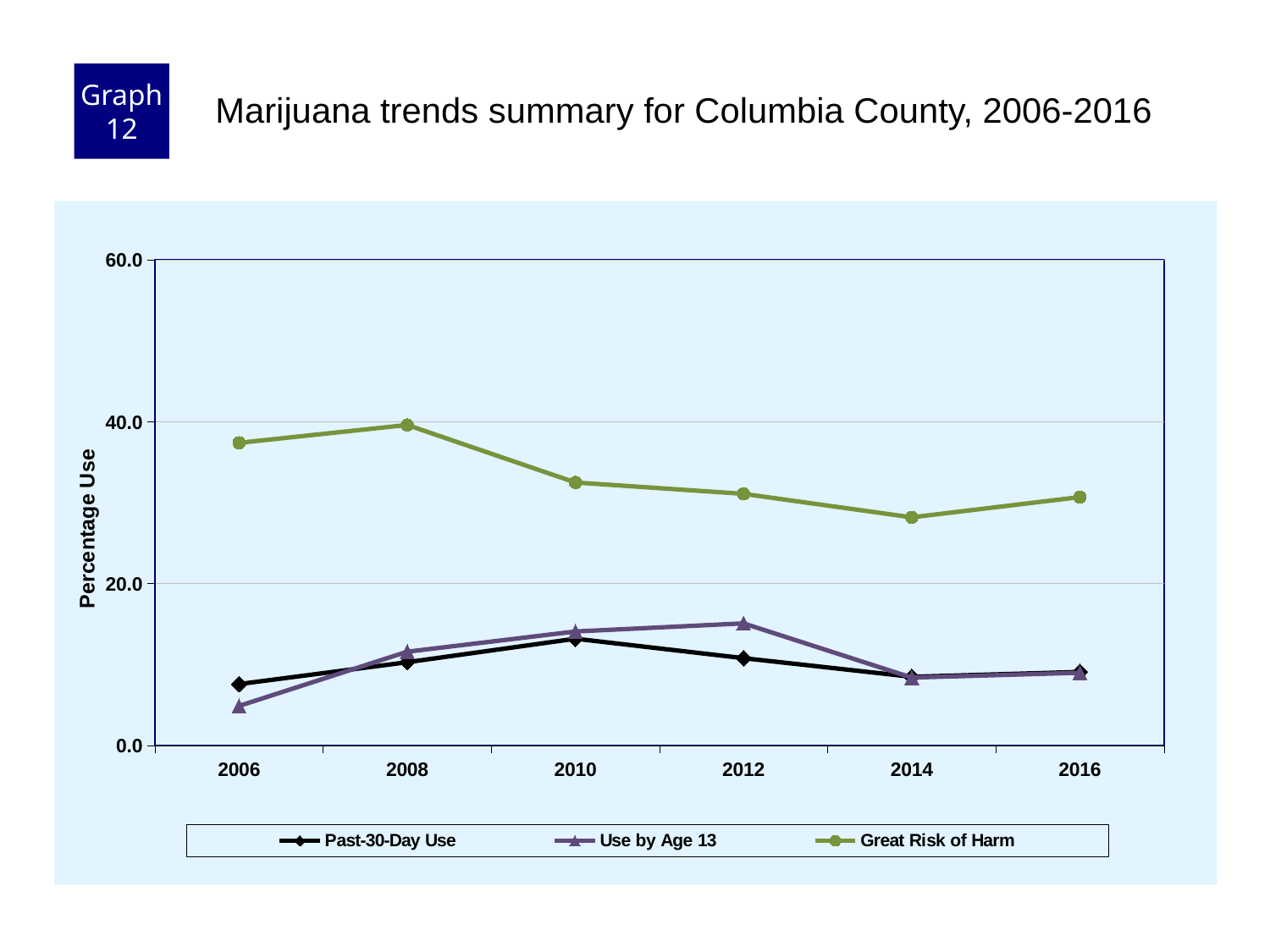
In 2006, which is larger: Past-30-Day Use or Use by Age 13? Past-30-Day Use What kind of chart is shown on the slide? Line chart In which year is the Great Risk of Harm series at its lowest? 2014 How many series does the legend list? 3 Is the Great Risk of Harm value for 2010 greater or less than 40.0? less How many years are plotted along the x axis? 6 In which year is the Great Risk of Harm series at its highest? 2008 In which year is the Past-30-Day Use series at its highest? 2010 Is the Great Risk of Harm value for 2014 greater or less than 20.0? greater What is the label on the y axis? Percentage Use In which year is the Use by Age 13 series at its lowest? 2006 Does the Great Risk of Harm series rise or fall from 2008 to 2014? Fall